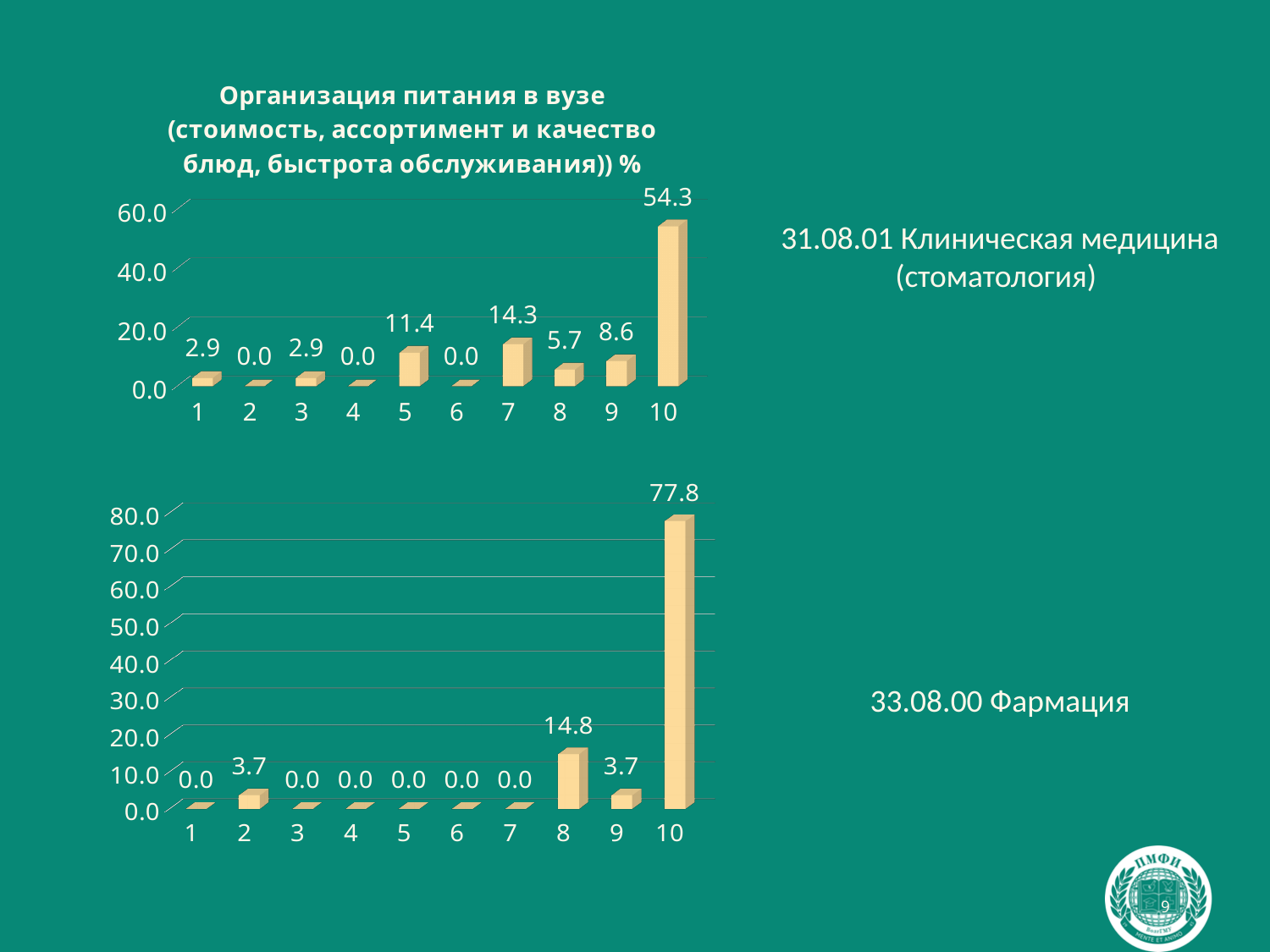
In the bottom chart, what is the value for category 8? 14.8 In the bottom chart, what is the difference between the values for category 10 and category 8? 63.0 In the top chart, which is larger, the value for category 5 or the value for category 9? category 5 What is the highest value shown on the y axis of the bottom chart? 80.0 In the top chart, what is the value for category 10? 54.3 What kind of chart is the bottom chart? bar chart In the top chart, what is the value for category 7? 14.3 In the bottom chart, how many categories have a value of 0.0? 6 In the top chart, what is the difference between the values for category 10 and category 7? 40.0 In the top chart, how many categories are shown on the x axis? 10 In the top chart, which category has the highest value? 10 In the bottom chart, what is the value for category 10? 77.8